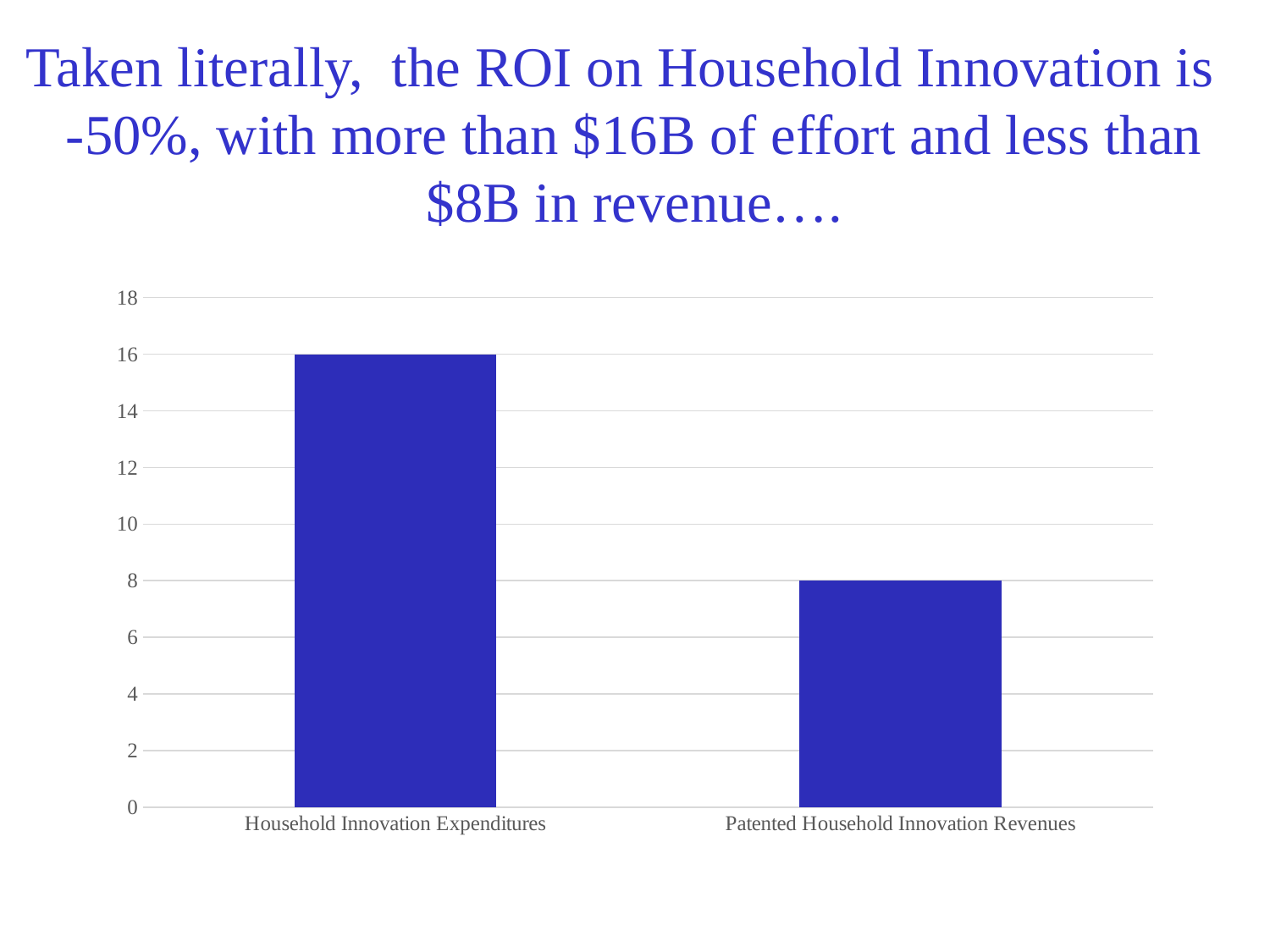
Which is larger, Household Innovation Expenditures or Patented Household Innovation Revenues? Household Innovation Expenditures How many categories are shown in the chart? 2 What is the value for Patented Household Innovation Revenues? 8 Which category has the highest value? Household Innovation Expenditures What colour are the bars in the chart? blue What is the difference between Household Innovation Expenditures and Patented Household Innovation Revenues? 8 What is the value for Household Innovation Expenditures? 16 Which category has the lowest value? Patented Household Innovation Revenues What is the highest value shown on the vertical axis? 18 Is the value for Patented Household Innovation Revenues greater or less than 10? less What kind of chart is shown on the slide? bar chart Is the value for Household Innovation Expenditures greater or less than 10? greater